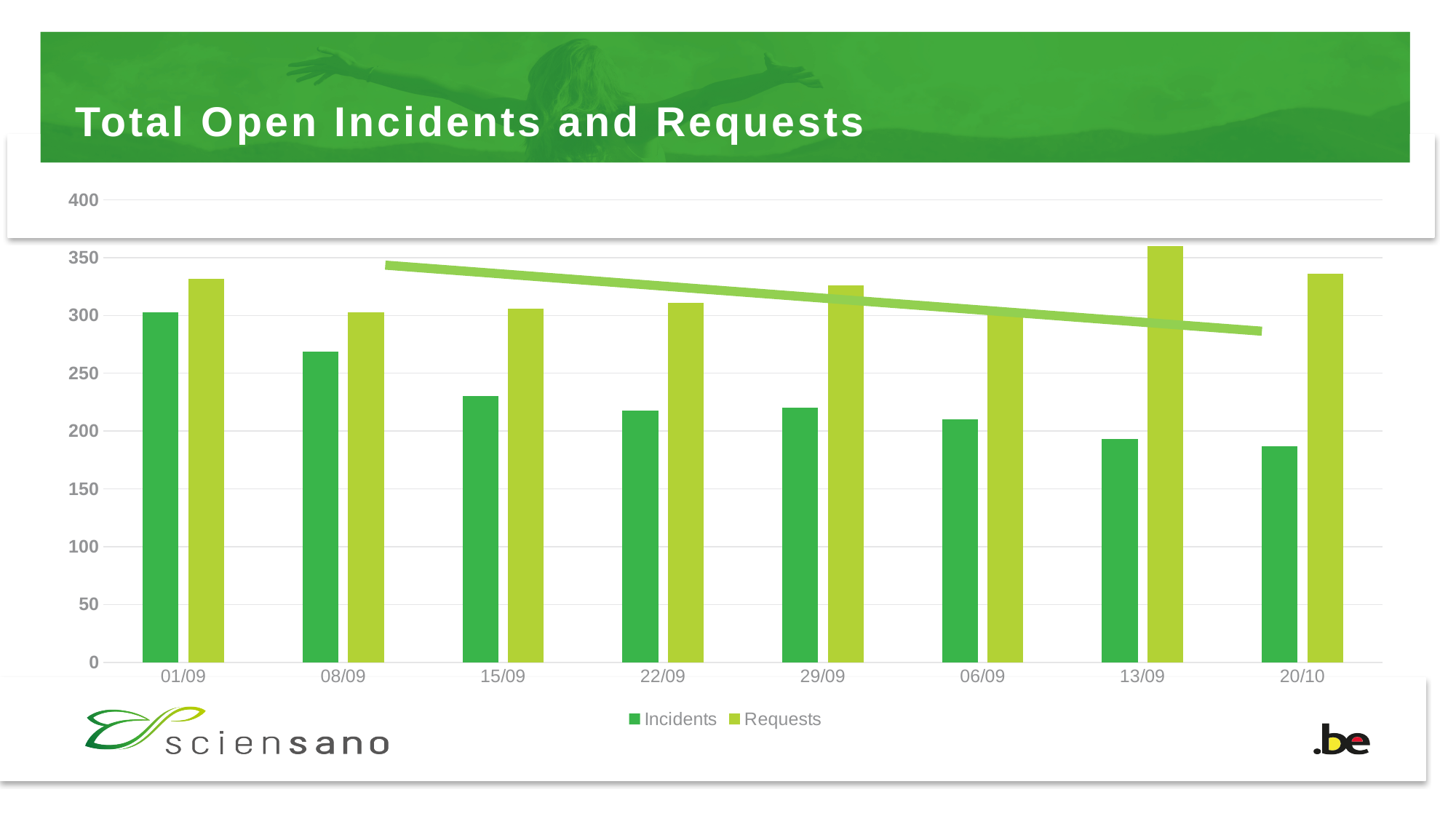
What kind of chart is shown on the slide? bar chart Is the Incidents value for 15/09 greater or less than 250? less How many series does the legend list? 2 What is the title of the chart? Total Open Incidents and Requests On which date is the Incidents value highest? 01/09 How many dates are shown on the x axis? 8 Is the Requests value for 13/09 greater or less than 350? greater Is the Incidents value for 20/10 greater or less than 200? less On which date is the Requests value highest? 13/09 Which is larger on 22/09, Incidents or Requests? Requests Do the Incidents values generally rise or fall from 01/09 to 20/10? fall